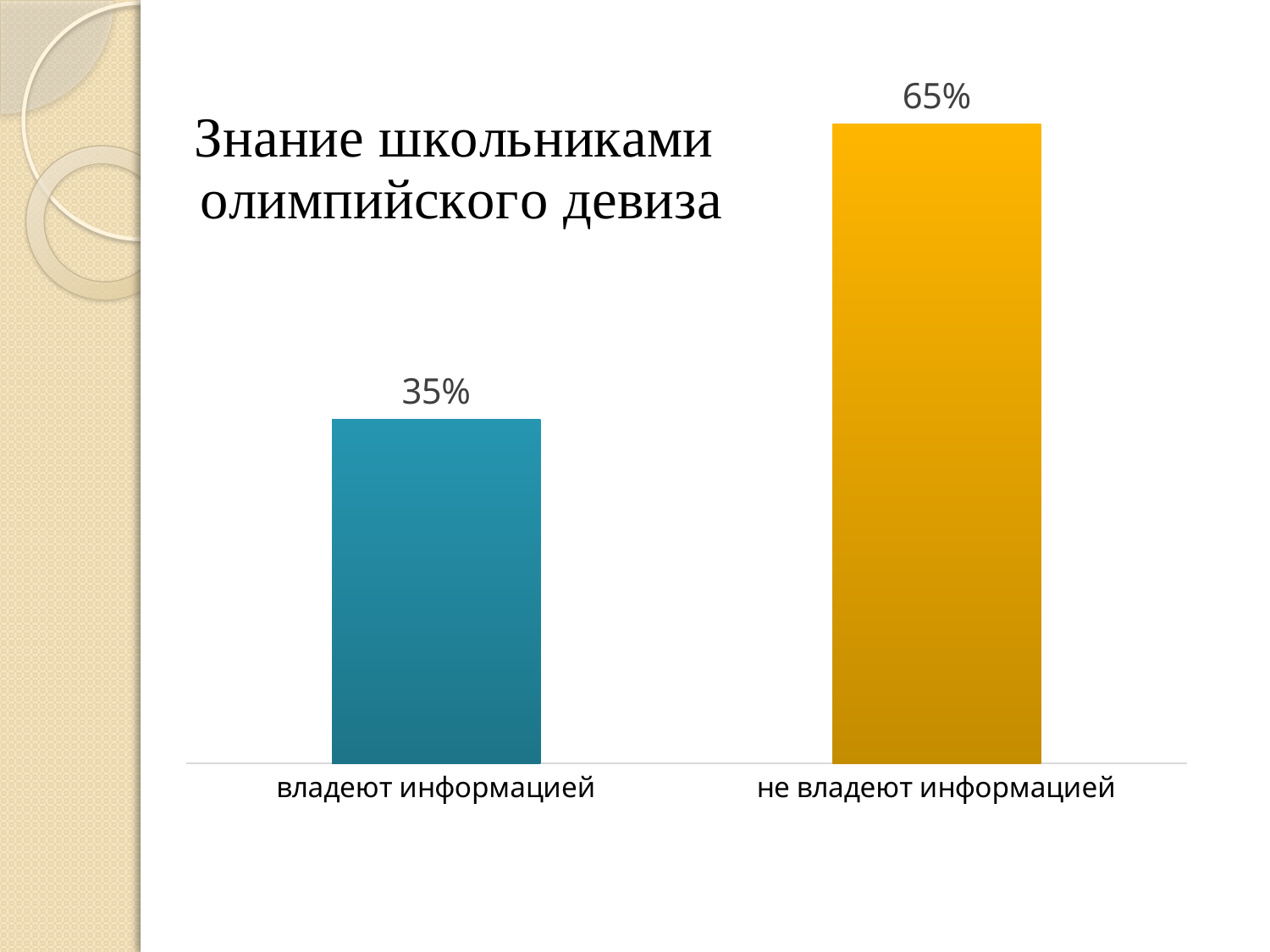
Which category has the highest value? не владеют информацией What is the total of the two values shown in the chart? 100% What colour is the bar for "не владеют информацией"? orange Which is larger: the value for "владеют информацией" or for "не владеют информацией"? не владеют информацией What kind of chart is shown on the slide? bar chart How many categories are shown in the chart? 2 Which category has the lowest value? владеют информацией What is the difference between the values for "не владеют информацией" and "владеют информацией"? 30% What is the value for "владеют информацией"? 35% What is the title of the slide? Знание школьниками олимпийского девиза What is the value for "не владеют информацией"? 65%